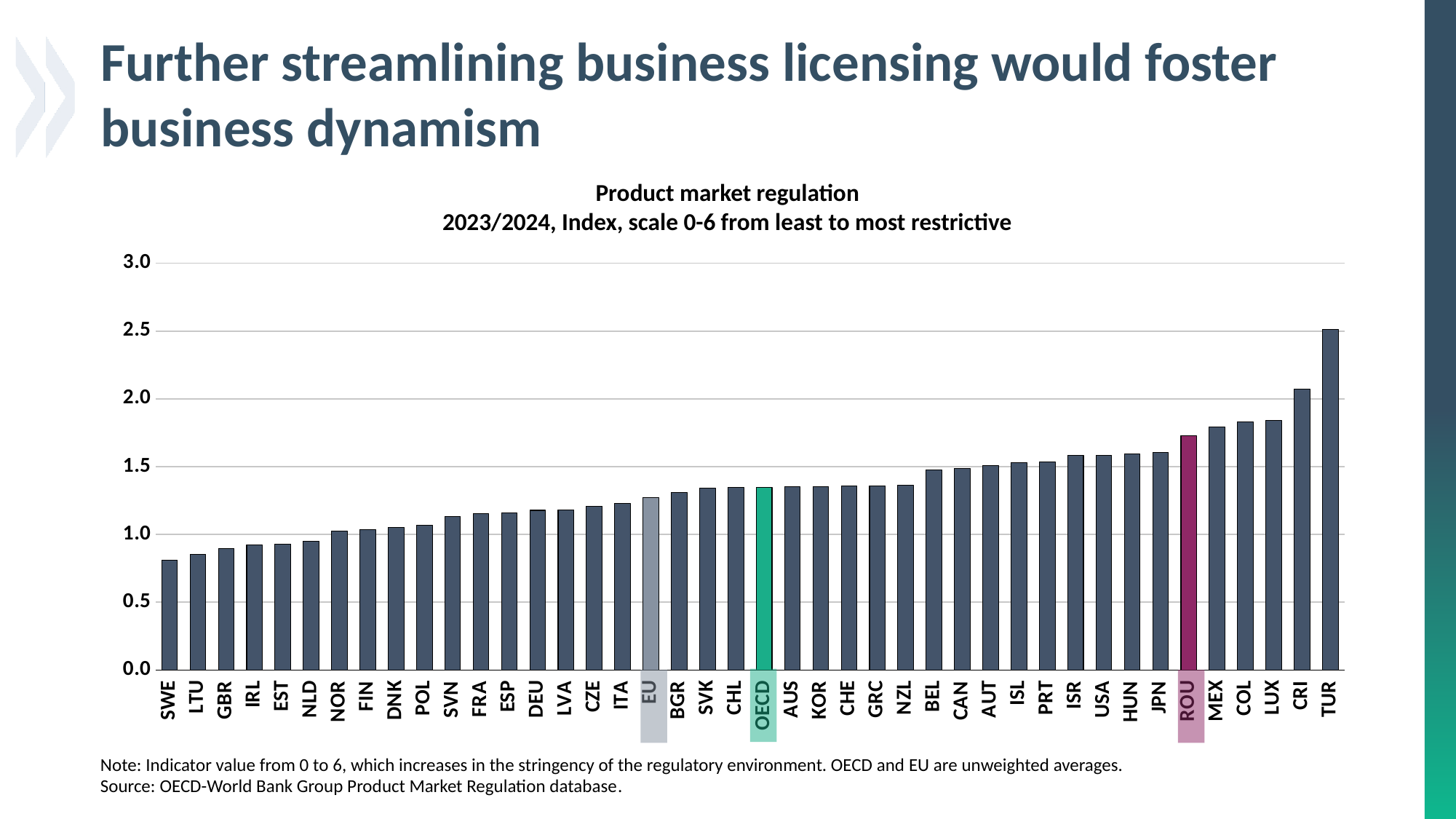
What is the title of the chart? Product market regulation Which country has the lowest product market regulation index value? SWE Is the value for SWE greater or less than 1.0? less How many bars (categories) are plotted in the chart? 42 Which has the larger value, ROU or OECD? ROU Is the value for ITA greater or less than 1.5? less What type of chart is shown on the slide? bar chart Is the value for CRI greater or less than 2.0? greater Which country has the highest product market regulation index value? TUR Do the bar values rise or fall moving from left to right along the x axis? rise